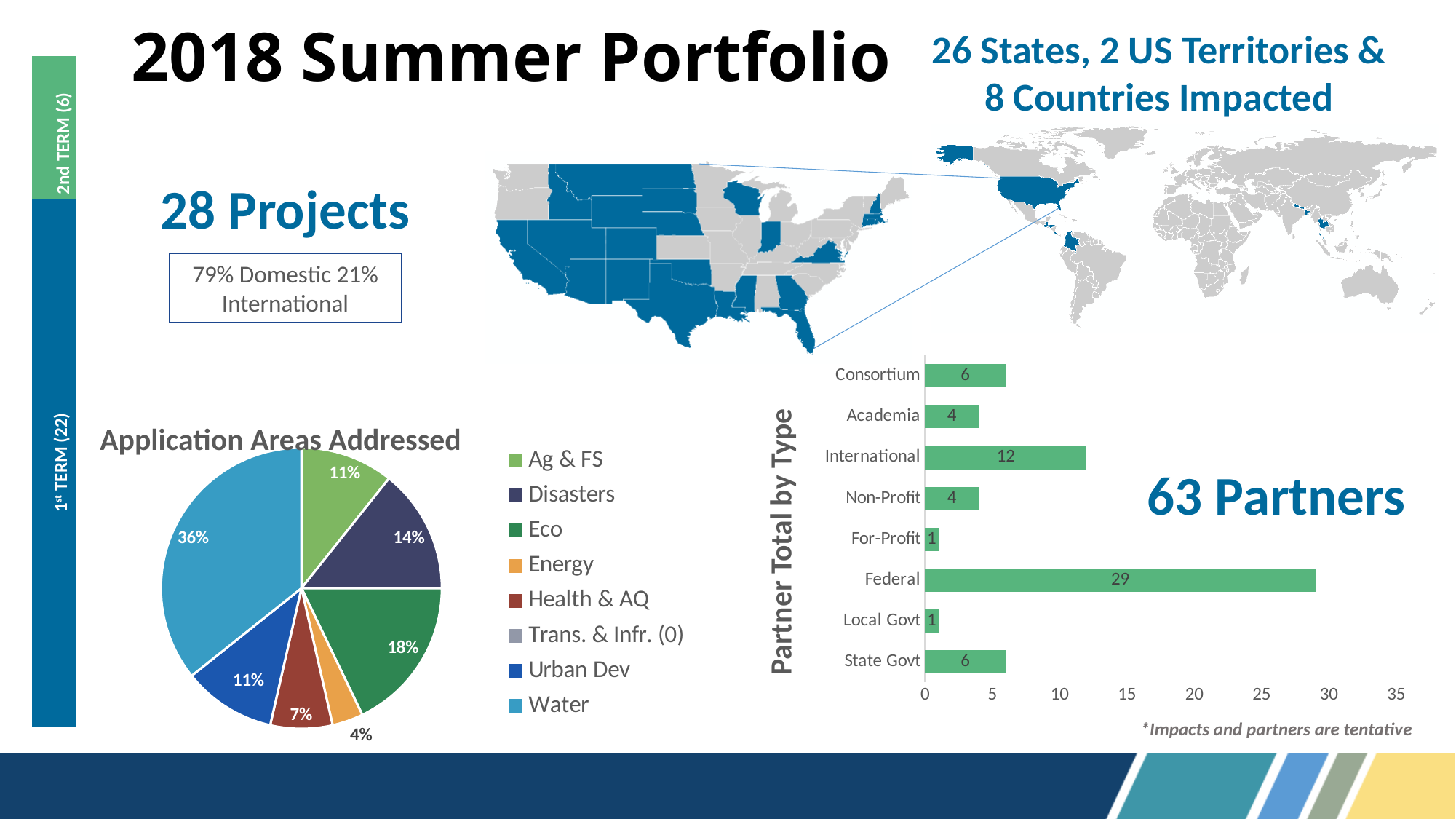
In the Application Areas Addressed pie chart, what is the difference between the Water share and the Eco share? 18% In the Application Areas Addressed pie chart, what share does Water have? 36% What kind of chart is the Partner Total by Type chart? Bar chart In the Application Areas Addressed pie chart, which application area has the largest share? Water In the Partner Total by Type chart, which partner type has the highest value? Federal In the Partner Total by Type chart, how many partner types are shown? 8 In the Partner Total by Type chart, what is the value for International? 12 In the Application Areas Addressed pie chart, how many entries does the legend list? 8 In the Application Areas Addressed pie chart, what share does Eco have? 18% In the Application Areas Addressed pie chart, which is larger, Disasters or Health & AQ? Disasters In the Partner Total by Type chart, what is the value for Federal? 29 In the Partner Total by Type chart, what is the difference between Federal and International? 17